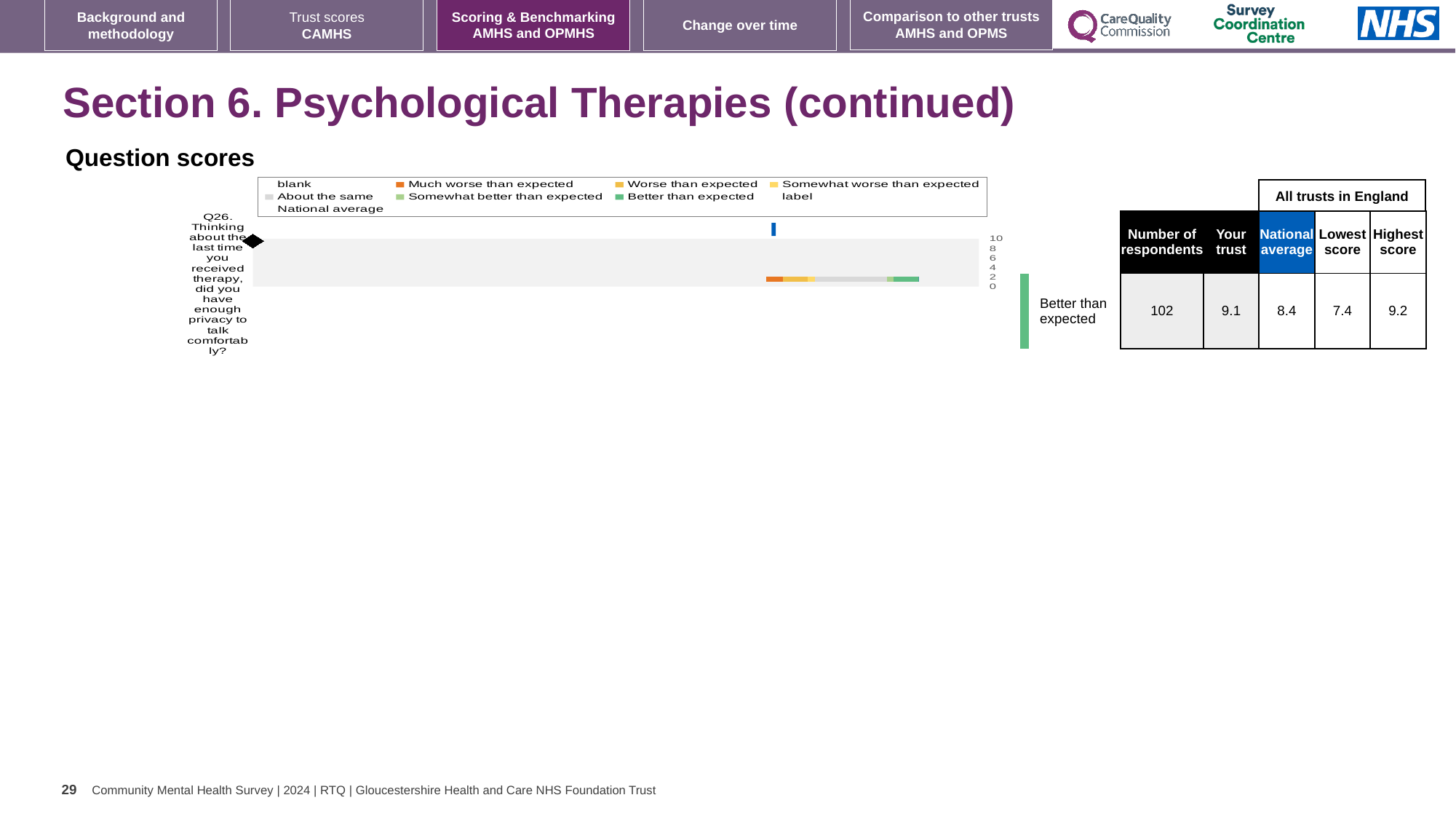
Which question is plotted on the chart? Q26. Thinking about the last time you received therapy, did you have enough privacy to talk comfortably? What is the lowest score among all trusts in England for Q26? 7.4 What is the highest score among all trusts in England for Q26? 9.2 What is the national average score for Q26? 8.4 How many respondents answered Q26? 102 What type of chart is used to show the Q26 question score? bar chart What is the difference between the highest and lowest scores for Q26 across all trusts in England? 1.8 Which is larger for Q26, the 'Your trust' score or the national average? Your trust What benchmark category is shown beside the chart for Q26? Better than expected How many survey questions are plotted on the chart? 1 What is the difference between the 'Your trust' score and the national average for Q26? 0.7 What is the 'Your trust' score for Q26? 9.1